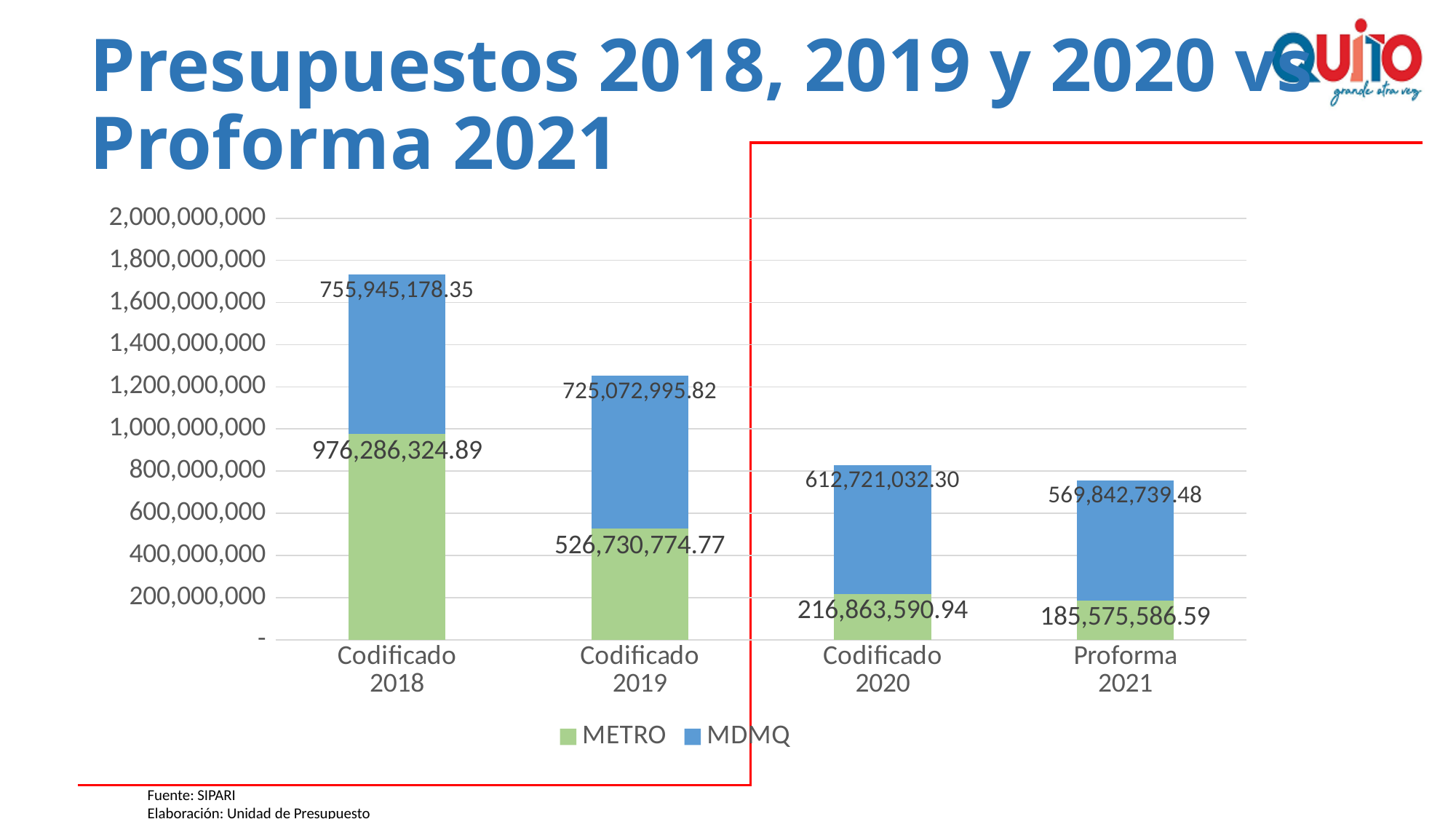
Which category has the lowest MDMQ value? Proforma 2021 What is the total of the stacked bar for Codificado 2020? 829,584,623.24 What is the METRO value for Codificado 2018? 976,286,324.89 What is the MDMQ value for Codificado 2020? 612,721,032.30 Do the total bar heights rise or fall from Codificado 2018 to Proforma 2021? Fall How many categories are shown on the x axis? 4 What type of chart is shown on the slide? Stacked bar chart What is the difference between the MDMQ values for Codificado 2018 and Codificado 2019? 30,872,182.53 Is the METRO value larger for Codificado 2019 or Codificado 2020? Codificado 2019 What is the MDMQ value for Proforma 2021? 569,842,739.48 How many series does the legend list? 2 Which category has the highest METRO value? Codificado 2018